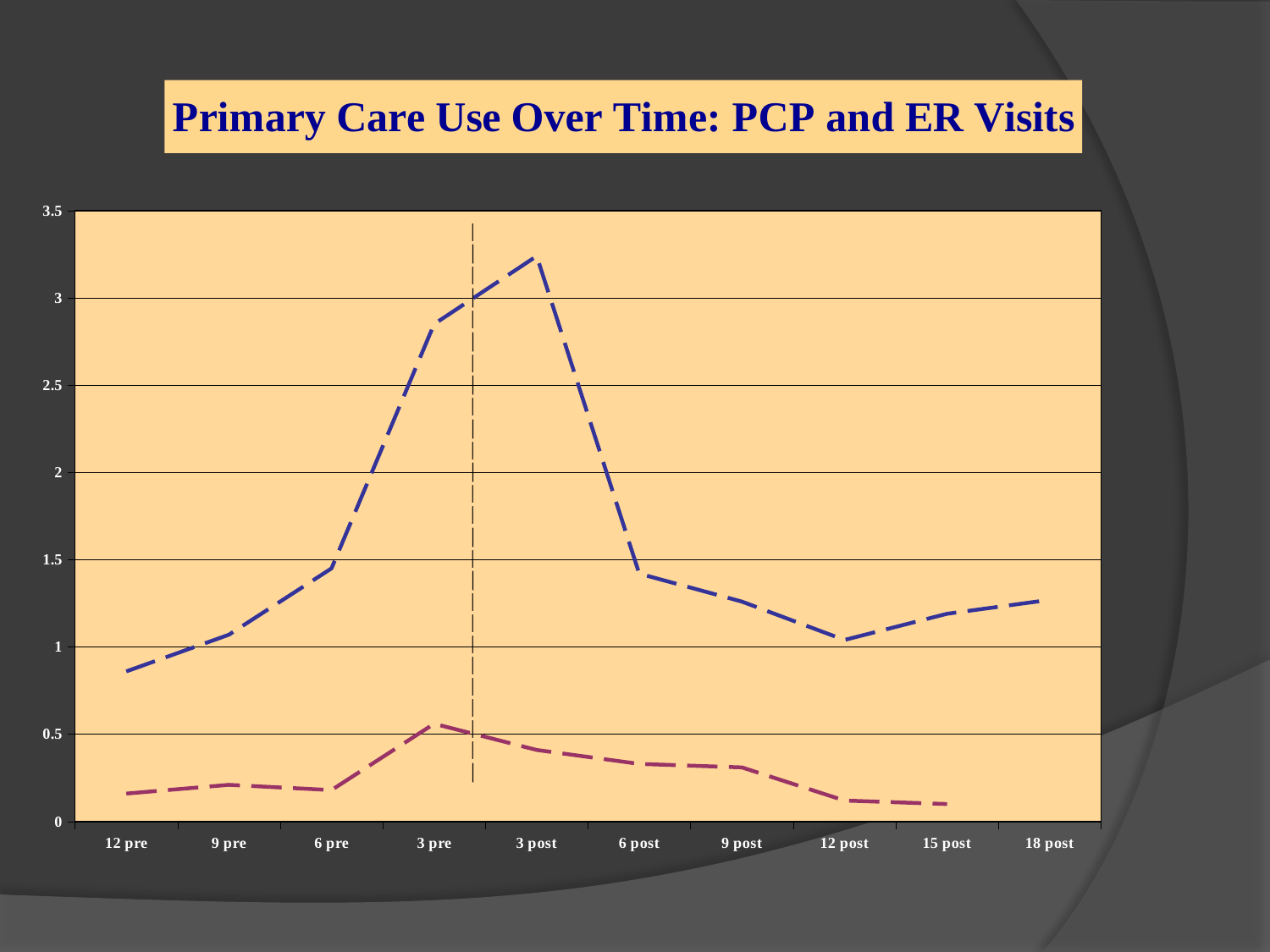
At which time point is the blue dashed line at its lowest value? 12 pre Is the value of the blue dashed line at 12 pre greater or less than 1? less Does the blue dashed line rise or fall from 3 post to 12 post? fall How many time-point categories are labelled on the x axis? 10 Is the value of the blue dashed line at 3 post greater or less than 3? greater What kind of chart is shown on the slide? line chart How many dashed lines are plotted on the chart? 2 What is the title of the chart? Primary Care Use Over Time: PCP and ER Visits Is the value of the purple dashed line at 12 pre greater or less than 0.5? less At which time point does the purple dashed line reach its highest value? 3 pre At which time point does the blue dashed line reach its highest value? 3 post